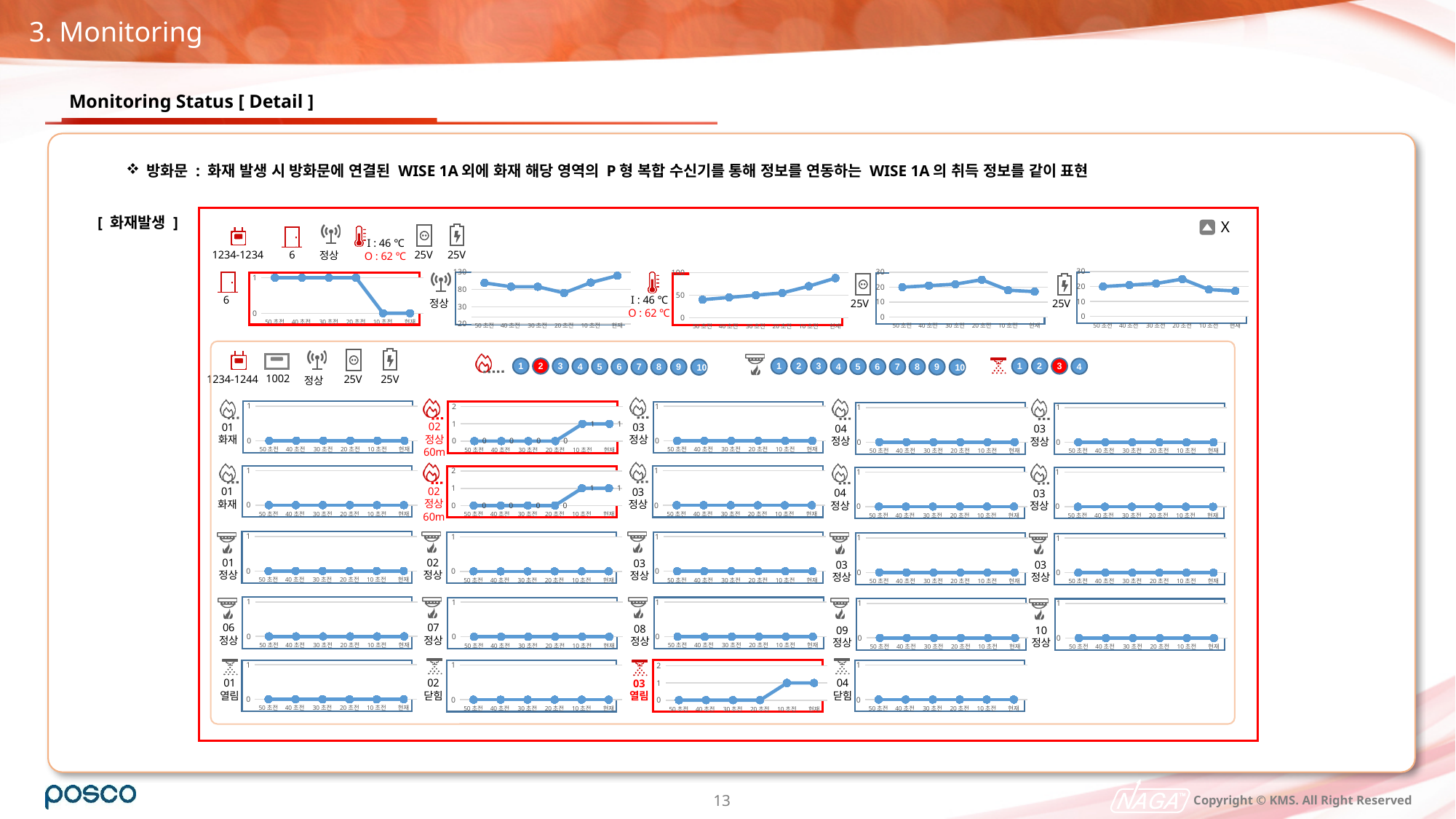
In the top-row door chart (labelled 6), what is the value at 50초전? 1 In the red-bordered chart for 03 열림 in the bottom row of the lower grid, does the value rise or fall from 50초전 to 현재? rise What kind of charts are shown in the monitoring panel on the slide? line charts In the top-row door chart (labelled 6), what is the value at 현재? 0 What is the label of the last x-axis tick on each small chart? 현재 In the top-row door chart (labelled 6), does the value rise or fall from 50초전 to 현재? fall In the top-row temperature chart (I : 46 °C / O : 62 °C), is the value at 현재 greater or less than 50? greater In the top-row temperature chart (I : 46 °C / O : 62 °C), does the value rise or fall from 50초전 to 현재? rise How many time points are plotted along the x axis of each small chart (from 50초전 to 현재)? 6 In the red-bordered chart for 02 정상 60m in the first row of the lower grid, what is the value at 현재? 1 In the red-bordered chart for 02 정상 60m in the first row of the lower grid, what is the value at 50초전? 0 In the top-row signal chart (정상), is the value at 현재 greater or less than 80? greater